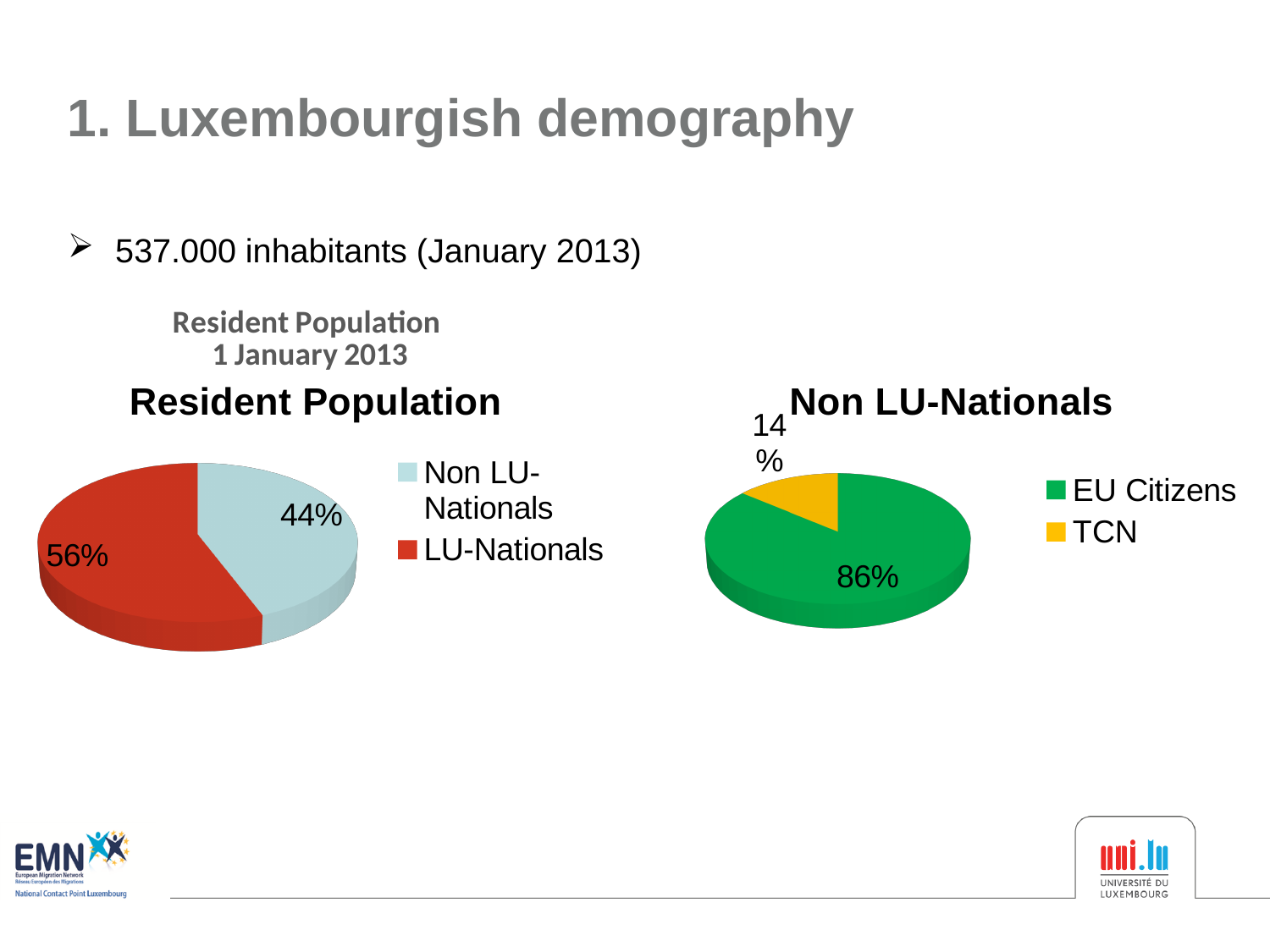
In the 'Resident Population' pie chart, which is larger: Non LU-Nationals or LU-Nationals? LU-Nationals In the 'Resident Population' pie chart, what is the difference between the LU-Nationals and Non LU-Nationals shares? 12% In the 'Resident Population' pie chart, which slice is the largest? LU-Nationals In the 'Non LU-Nationals' pie chart, what is the difference between the EU Citizens and TCN shares? 72% How many slices does the 'Non LU-Nationals' pie chart have? 2 In the 'Non LU-Nationals' pie chart, what share is EU Citizens? 86% In the 'Resident Population' pie chart, what share is LU-Nationals? 56% In the 'Non LU-Nationals' pie chart, which slice is the smallest? TCN In the 'Resident Population' pie chart, what share is Non LU-Nationals? 44% In the 'Non LU-Nationals' pie chart, what share is TCN? 14% What type of chart is the 'Resident Population' chart? Pie chart In the 'Non LU-Nationals' pie chart, what colour is the TCN slice? Yellow